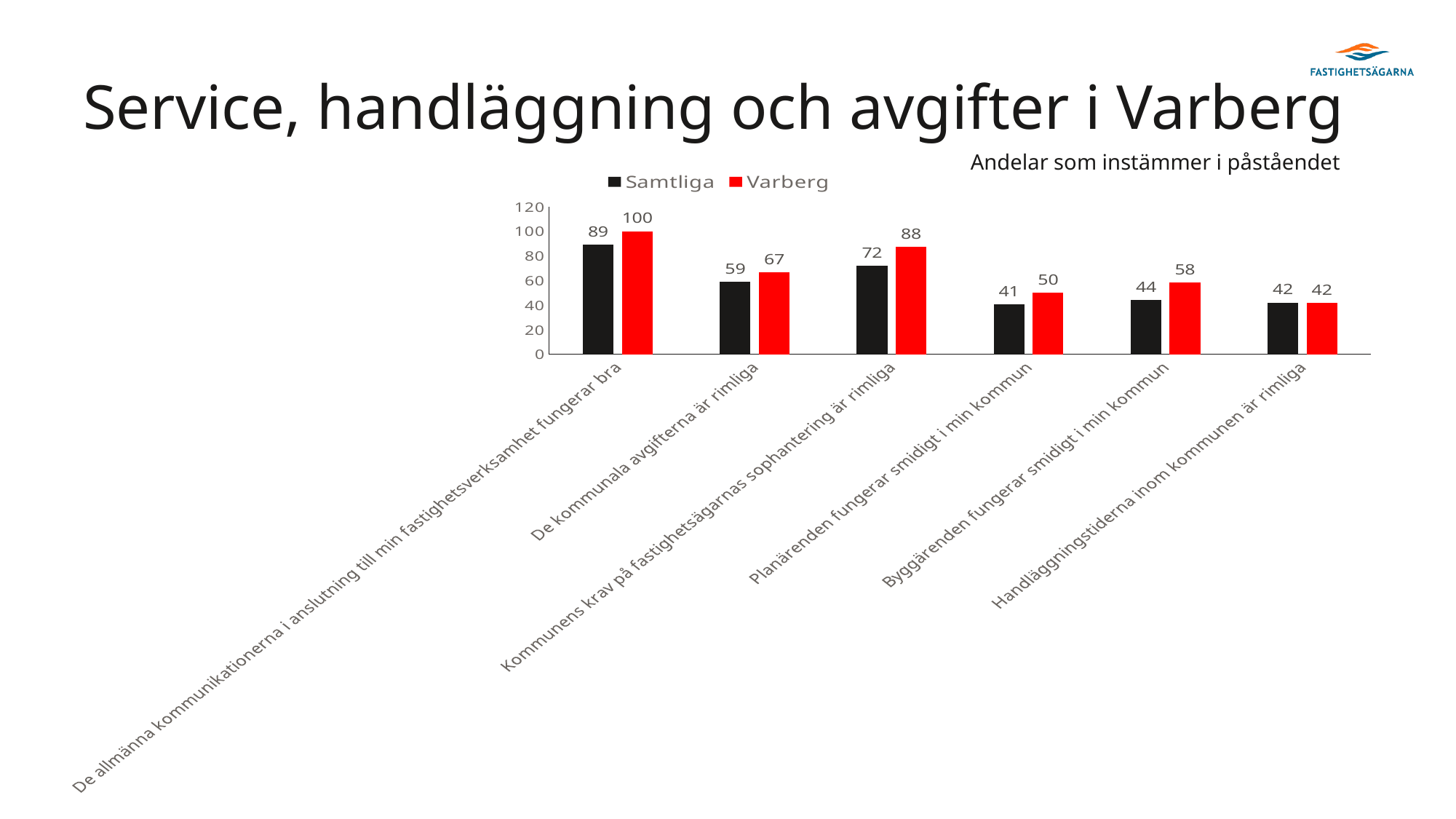
How many categories are shown on the x axis? 6 Which category has the lowest Samtliga value? Planärenden fungerar smidigt i min kommun What is the Samtliga value for "Planärenden fungerar smidigt i min kommun"? 41 What is the Varberg value for "De kommunala avgifterna är rimliga"? 67 Which category has the highest Varberg value? De allmänna kommunikationerna i anslutning till min fastighetsverksamhet fungerar bra Is the Samtliga value for "De kommunala avgifterna är rimliga" greater or less than 40? greater Which colour represents the Varberg series? Red What is the Varberg value for "Kommunens krav på fastighetsägarnas sophantering är rimliga"? 88 Which is larger for "Kommunens krav på fastighetsägarnas sophantering är rimliga": Samtliga or Varberg? Varberg What is the difference between the Varberg and Samtliga values for "Byggärenden fungerar smidigt i min kommun"? 14 What kind of chart is shown on the slide? Bar chart How many series does the legend list? 2